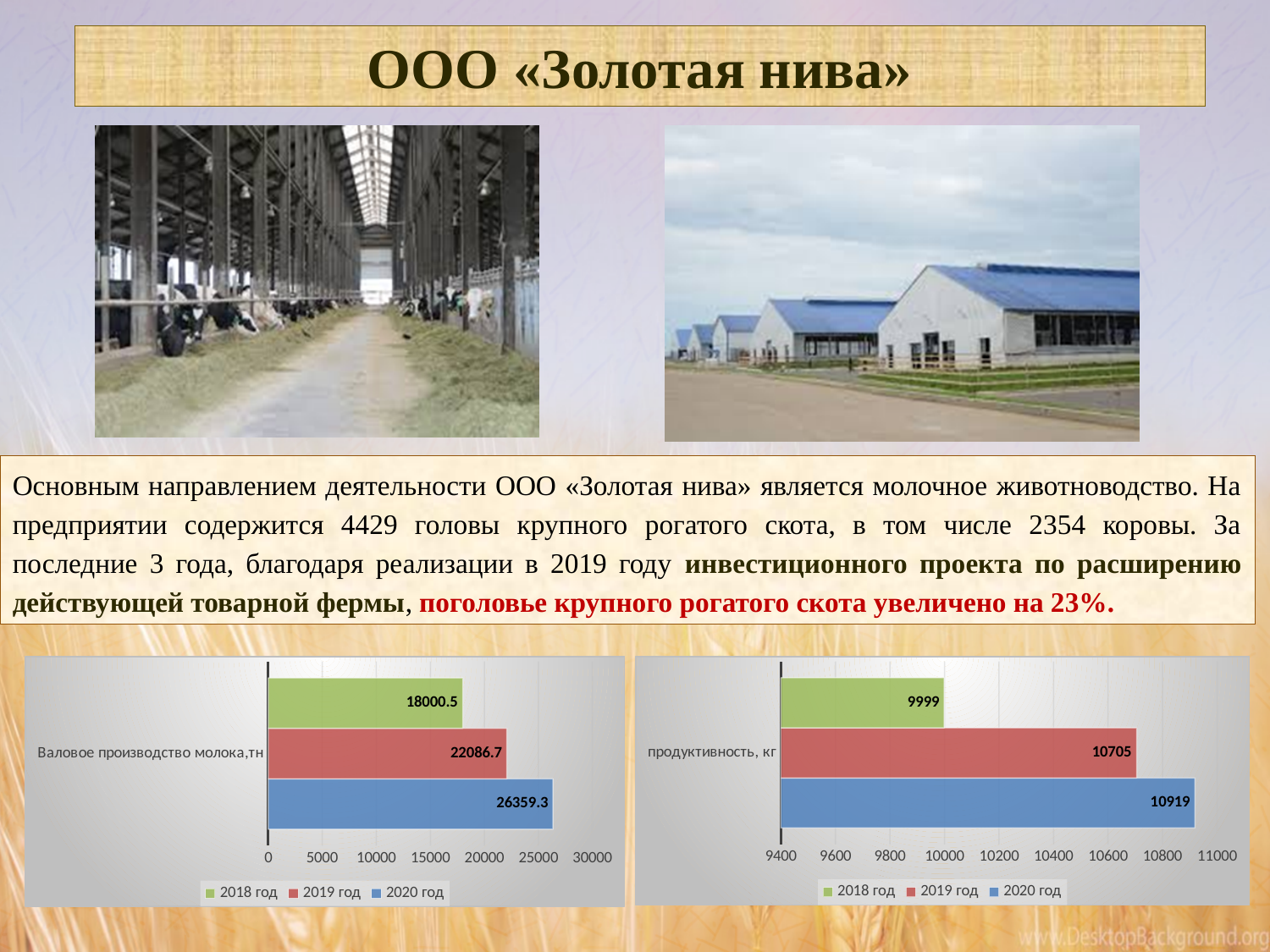
In the left chart (Валовое производство молока,тн), what is the value for 2018 год? 18000.5 In the left chart (Валовое производство молока,тн), which is larger: the value for 2019 год or 2018 год? 2019 год In the right chart (продуктивность, кг), what is the value for 2020 год? 10919 In the right chart (продуктивность, кг), do the values rise or fall from 2018 год to 2020 год? rise What kind of chart is the left chart (Валовое производство молока,тн)? bar chart In the left chart (Валовое производство молока,тн), which year has the highest value? 2020 год In the left chart (Валовое производство молока,тн), what is the value for 2020 год? 26359.3 In the left chart (Валовое производство молока,тн), is the value for 2019 год greater or less than 20000? greater How many series does the legend of the right chart (продуктивность, кг) list? 3 In the right chart (продуктивность, кг), which year has the lowest value? 2018 год In the right chart (продуктивность, кг), what is the value for 2019 год? 10705 In the right chart (продуктивность, кг), what is the difference between the 2020 год and 2018 год values? 920